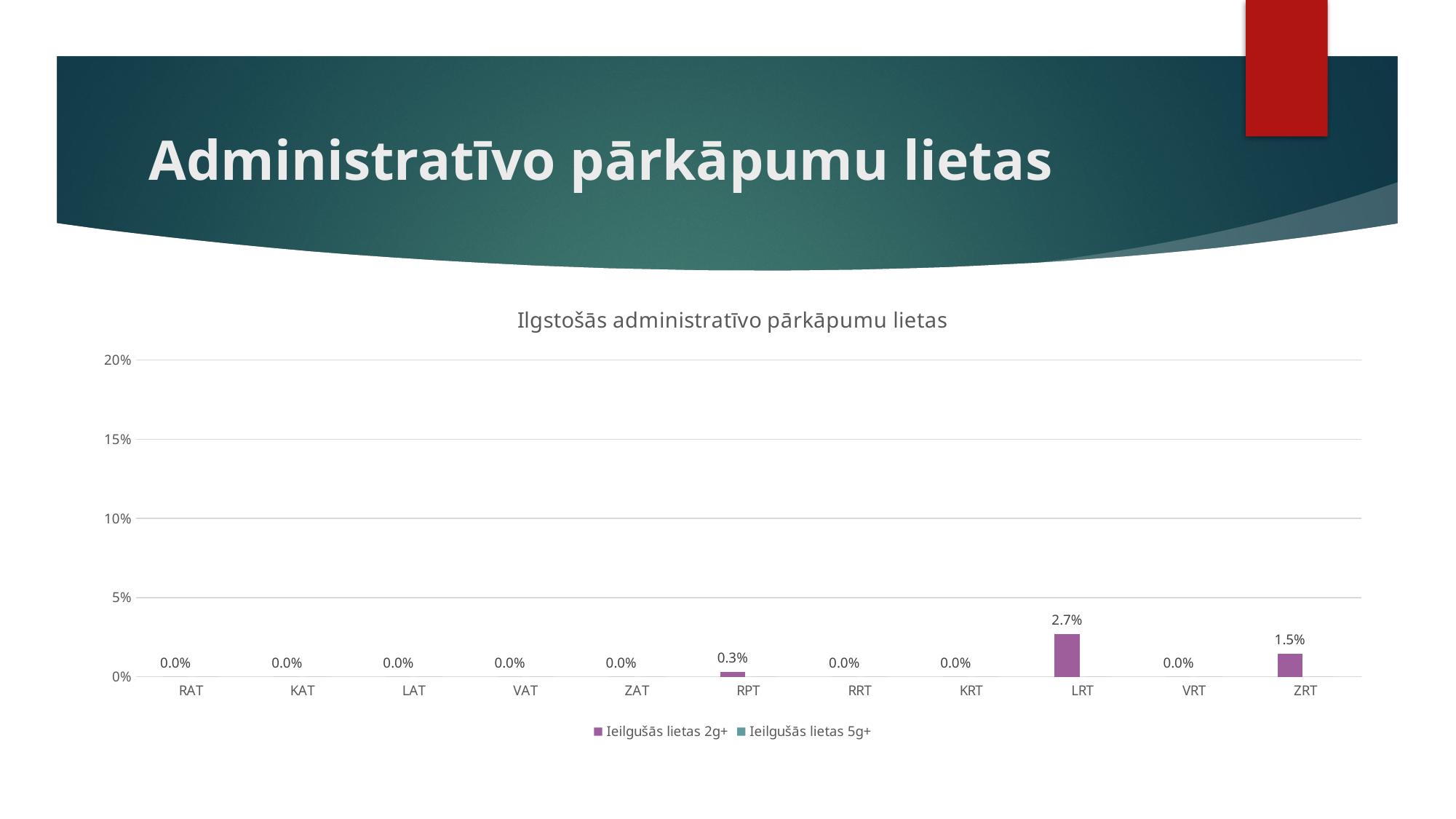
Which category has the highest value for Ieilgušās lietas 2g+? LRT What is the value of Ieilgušās lietas 2g+ for KAT? 0.0% How many series does the chart legend list? 2 What is the value of Ieilgušās lietas 2g+ for LRT? 2.7% What is the value of Ieilgušās lietas 2g+ for ZRT? 1.5% What is the value of Ieilgušās lietas 2g+ for RPT? 0.3% Is the Ieilgušās lietas 2g+ value for LRT greater or less than 5%? less Which is larger, the Ieilgušās lietas 2g+ value for ZRT or for RPT? ZRT What is the title of the chart? Ilgstošās administratīvo pārkāpumu lietas What kind of chart is shown on the slide? Bar chart How many categories are shown on the x axis of the chart? 11 What is the difference between the Ieilgušās lietas 2g+ values for LRT and ZRT? 1.2%